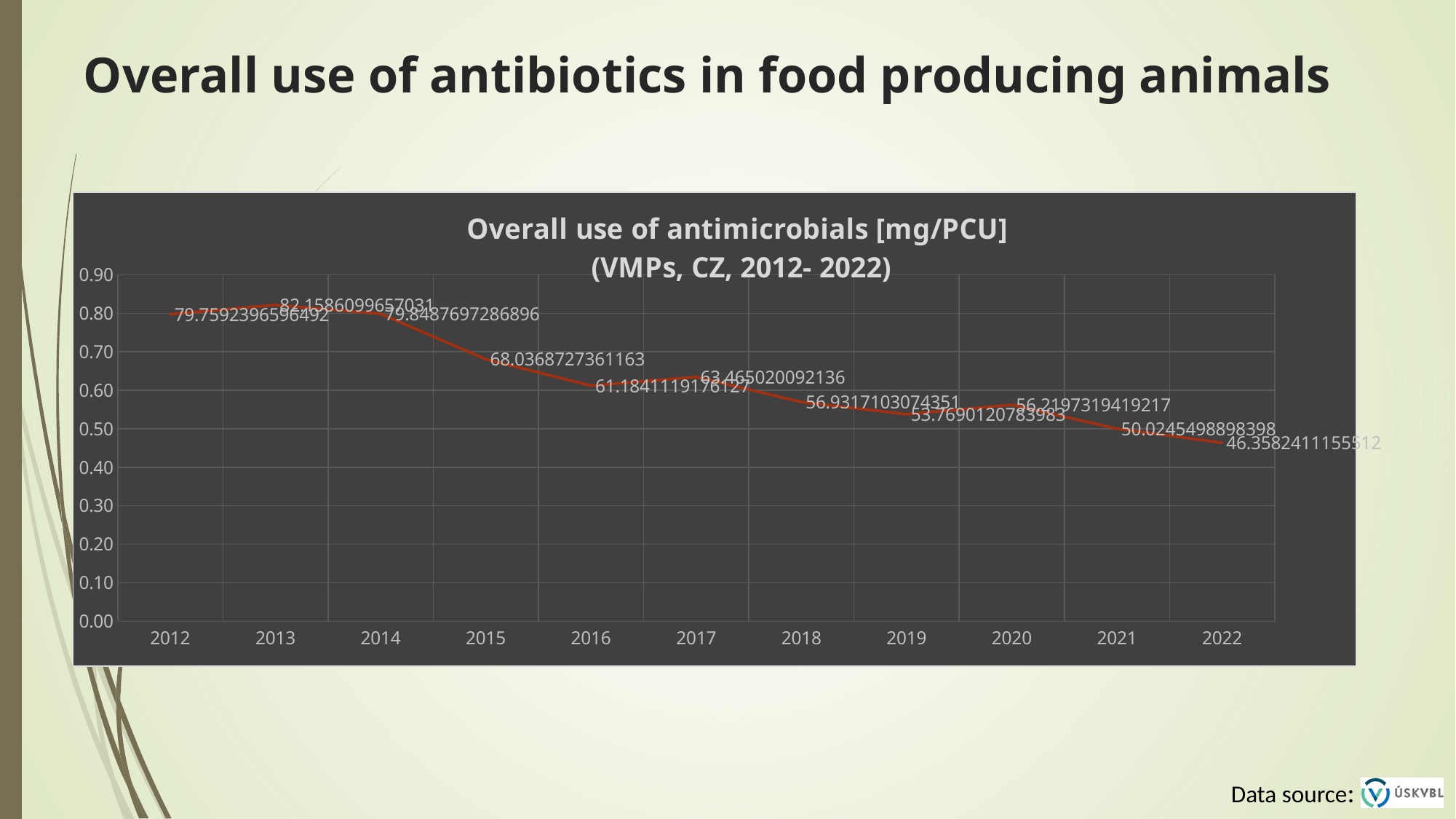
How many years are plotted on the x axis? 11 Which is larger, the value for 2017 or the value for 2016? 2017 Is the value for 2019 greater or less than 0.50 on the axis? greater What is the value for 2015? 68.0368727361163 Which year has the lowest value? 2022 Do the values generally rise or fall from 2012 to 2022? fall Is the value for 2022 greater or less than 0.50 on the axis? less What is the value for 2021? 50.0245498898398 Which year has the highest value? 2013 What is the value for 2018? 56.9317103074351 What is the value for 2013? 82.1586099657031 What kind of chart is shown? line chart